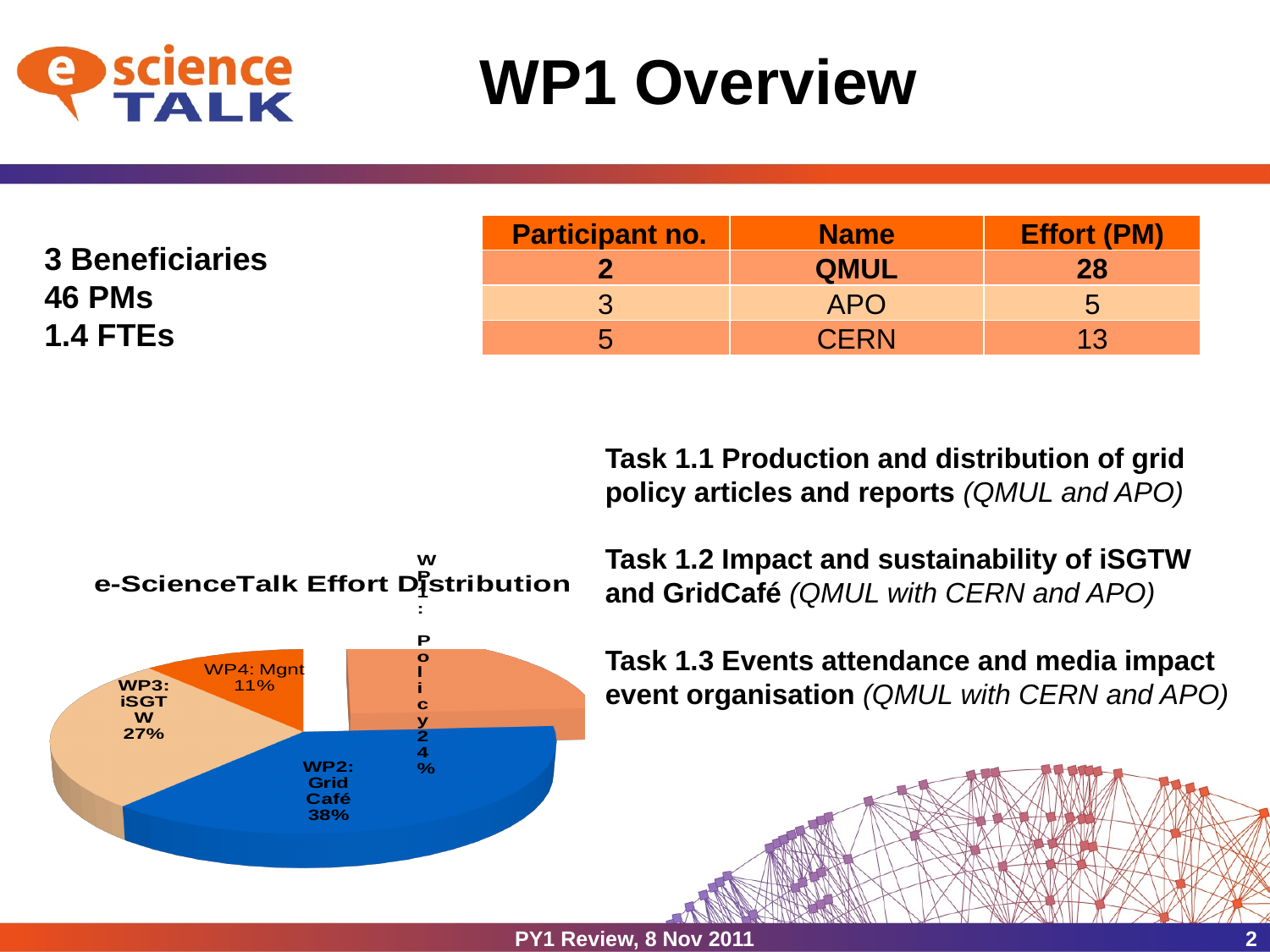
How many slices does the pie chart have? 4 What share of the pie does WP4: Mgnt have? 11% Which slice of the pie chart is the largest? WP2: Grid Café What kind of chart is the e-ScienceTalk Effort Distribution chart? pie chart Which is larger, the share for WP1: Policy or the share for WP4: Mgnt? WP1: Policy What is the difference in percentage points between WP2: Grid Café and WP3: iSGTW? 11 What is the title of the pie chart on the slide? e-ScienceTalk Effort Distribution What is the difference in percentage points between WP3: iSGTW and WP1: Policy? 3 What share of the pie does WP2: Grid Café have? 38% What share of the pie does WP1: Policy have? 24% Which slice of the pie chart is the smallest? WP4: Mgnt What share of the pie does WP3: iSGTW have? 27%